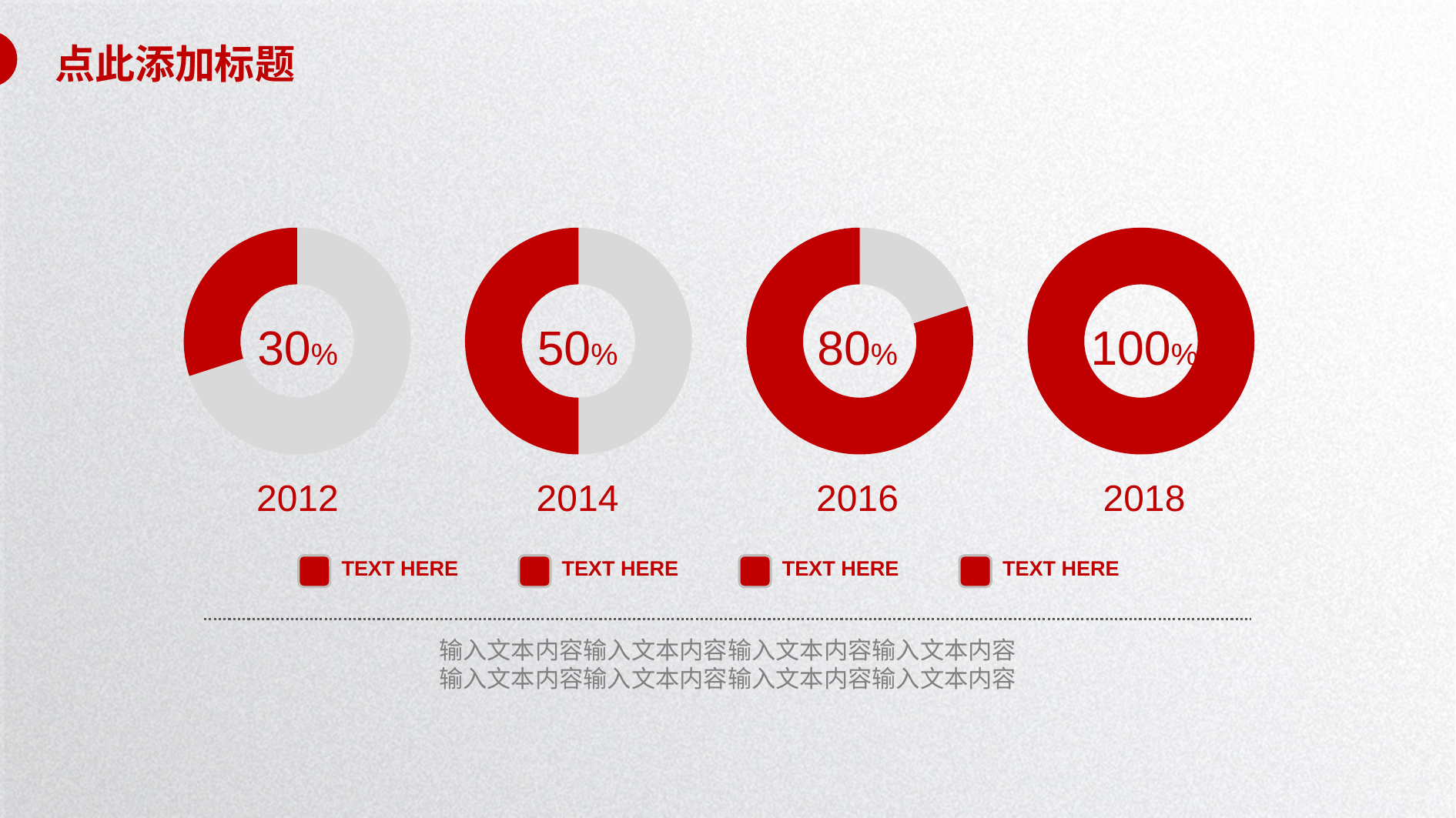
What value is shown in the donut chart labelled 2014? 50% What kind of chart is used to show the values for each year? Donut chart Which year's donut chart shows the highest value? 2018 How many donut charts are shown on the slide? 4 What is the difference between the value for 2018 and the value for 2014? 50% What value is shown in the donut chart labelled 2016? 80% What value is shown in the donut chart labelled 2018? 100% What is the difference between the value for 2016 and the value for 2012? 50% What value is shown in the donut chart labelled 2012? 30% Do the values rise or fall from 2012 to 2018? Rise Which is larger, the value for 2014 or the value for 2016? 2016 Which year's donut chart shows the lowest value? 2012